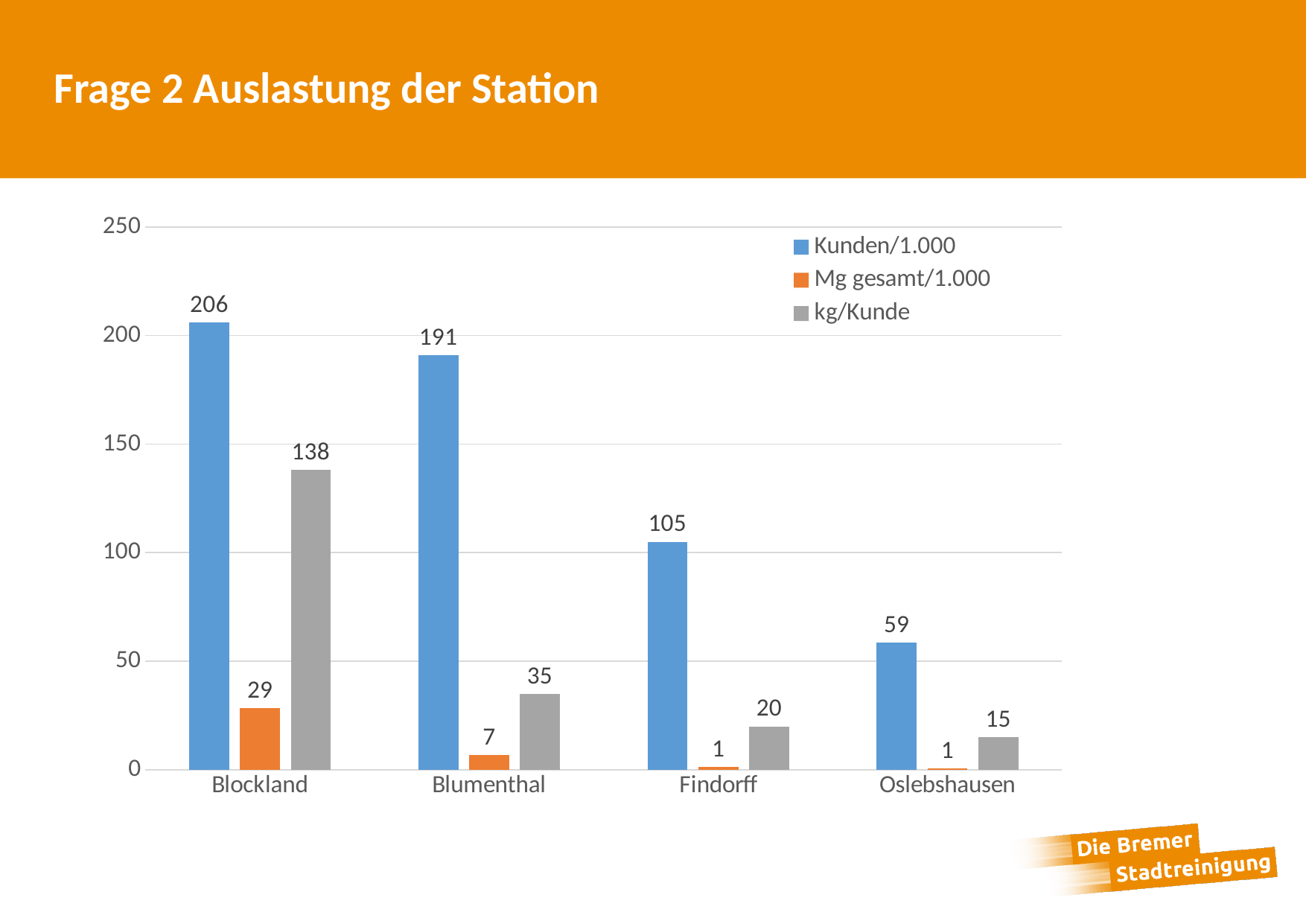
How many series does the legend list? 3 What is the Mg gesamt/1.000 value for Findorff? 1 How many stations are shown on the x axis? 4 Which is larger: the kg/Kunde value for Findorff or for Oslebshausen? Findorff Which station has the lowest kg/Kunde value? Oslebshausen What is the title of the slide? Frage 2 Auslastung der Station What is the difference between the Kunden/1.000 values for Blockland and Blumenthal? 15 What is the Kunden/1.000 value for Blockland? 206 What is the kg/Kunde value for Blumenthal? 35 Is the Kunden/1.000 value for Findorff greater or less than 100? greater Which station has the highest Kunden/1.000 value? Blockland What kind of chart is shown on the slide? bar chart